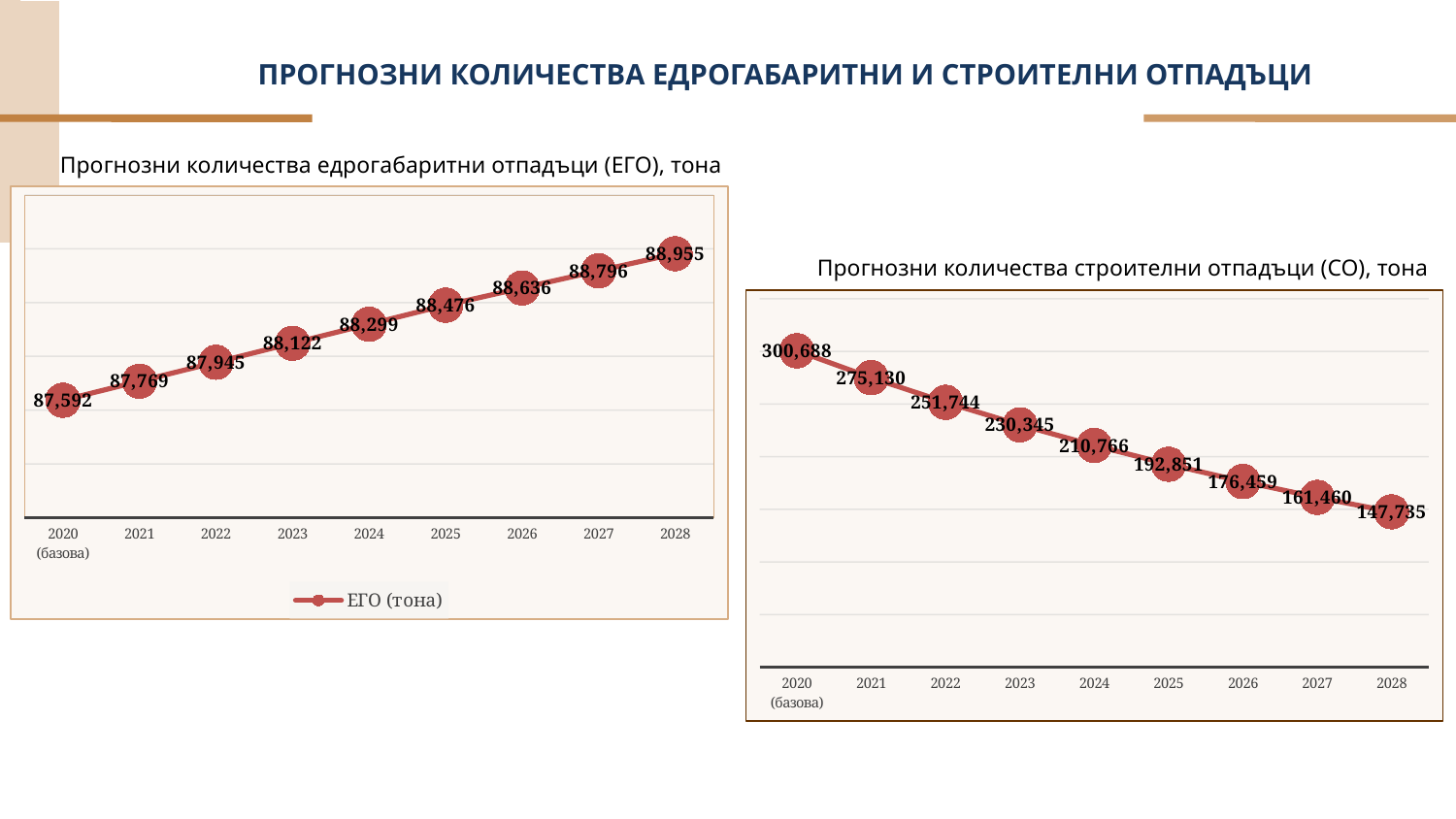
In the chart 'Прогнозни количества строителни отпадъци (СО), тона', do the values rise or fall from 2020 to 2028? fall In the chart 'Прогнозни количества строителни отпадъци (СО), тона', what is the value for 2028? 147,735 In the chart 'Прогнозни количества едрогабаритни отпадъци (ЕГО), тона', what is the value for 2024? 88,299 In the chart 'Прогнозни количества едрогабаритни отпадъци (ЕГО), тона', do the values rise or fall from 2020 to 2028? rise In the chart 'Прогнозни количества строителни отпадъци (СО), тона', what is the difference between the 2020 value and the 2021 value? 25,558 In the chart 'Прогнозни количества едрогабаритни отпадъци (ЕГО), тона', what is the difference between the 2028 value and the 2020 value? 1,363 What type of chart is 'Прогнозни количества едрогабаритни отпадъци (ЕГО), тона'? line chart How many years are plotted in the chart 'Прогнозни количества строителни отпадъци (СО), тона'? 9 In the chart 'Прогнозни количества строителни отпадъци (СО), тона', which year has the lowest value? 2028 In the chart 'Прогнозни количества едрогабаритни отпадъци (ЕГО), тона', which year has the highest value? 2028 In the chart 'Прогнозни количества строителни отпадъци (СО), тона', which year has the highest value? 2020 (базова) In the chart 'Прогнозни количества строителни отпадъци (СО), тона', what is the value for 2023? 230,345